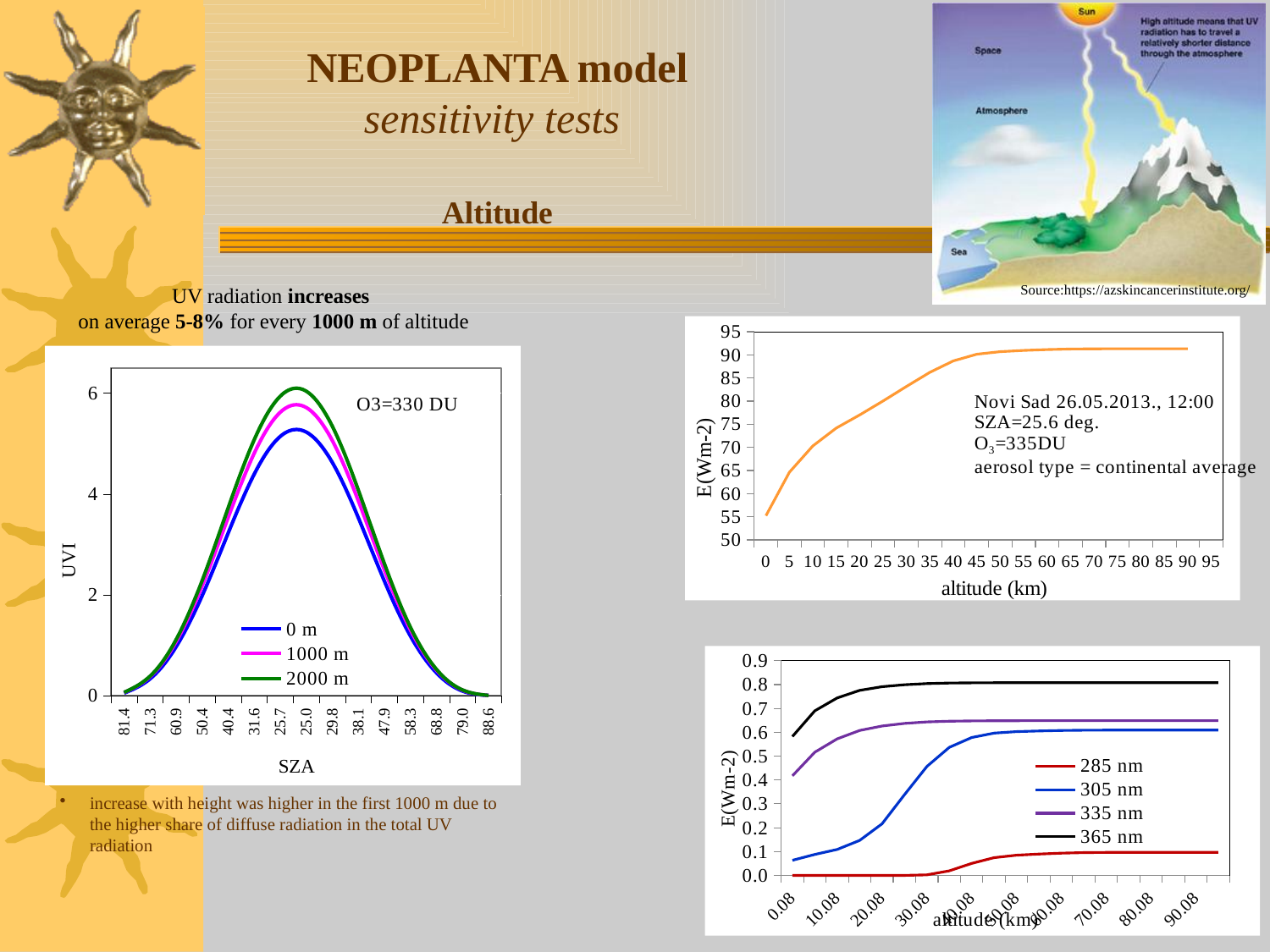
In the UVI versus SZA chart on the left, what kind of chart is it? line chart In the top-right E(Wm-2) versus altitude chart, is the value at 90 km altitude greater or less than 85? greater In the top-right E(Wm-2) versus altitude chart, does the value rise or fall as altitude increases? rise In the top-right E(Wm-2) versus altitude chart, is the value at 0 km altitude greater or less than 60? less In the UVI versus SZA chart on the left, which series reaches the highest peak UVI? 2000 m In the bottom-right E(Wm-2) versus altitude chart, how many series does the legend list? 4 In the UVI versus SZA chart on the left, what ozone value is annotated on the chart? O3=330 DU In the UVI versus SZA chart on the left, is the peak UVI of the 0 m series greater or less than 6? less In the UVI versus SZA chart on the left, how many series does the legend list? 3 In the bottom-right E(Wm-2) versus altitude chart, which wavelength series has the highest values? 365 nm In the UVI versus SZA chart on the left, which series has the lowest peak UVI? 0 m